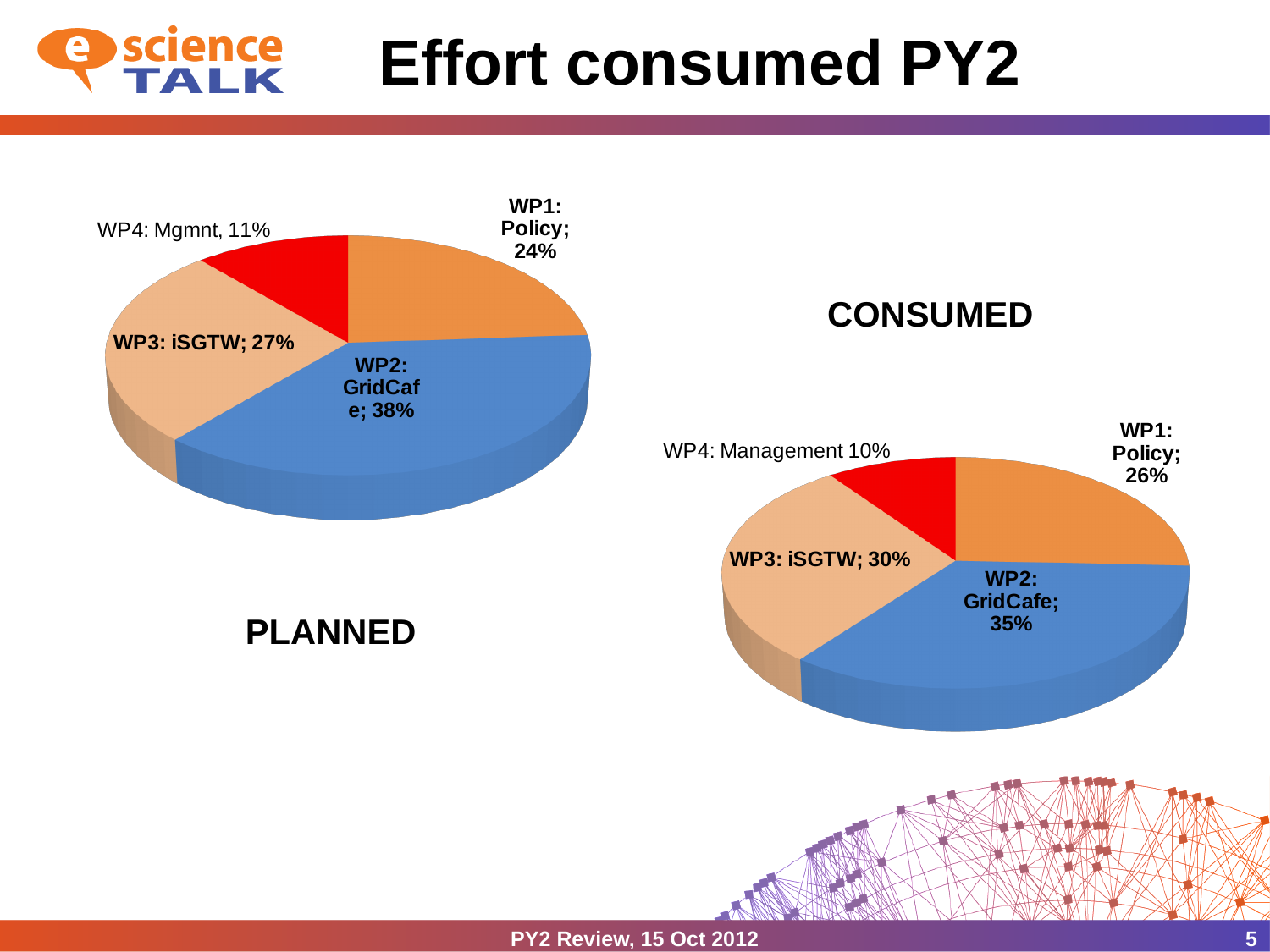
Which is larger: the WP1: Policy share in the PLANNED chart or the WP1: Policy share in the CONSUMED chart? CONSUMED In the PLANNED pie chart, what is the value for WP4: Mgmnt? 11% What type of chart is the CONSUMED chart? Pie chart In the CONSUMED pie chart, which work package has the smallest share? WP4: Management How many slices does the PLANNED pie chart have? 4 In the CONSUMED pie chart, what is the difference between the WP2: GridCafe share and the WP1: Policy share? 9% In the PLANNED pie chart, which work package has the largest share? WP2: GridCafe In the CONSUMED pie chart, what is the value for WP1: Policy? 26% In the CONSUMED pie chart, what share of effort is WP3: iSGTW? 30% In the PLANNED pie chart, what is the difference between the WP3: iSGTW share and the WP4: Mgmnt share? 16% What colour is the WP4 slice in both pie charts? Red In the PLANNED pie chart, what share of effort is WP2: GridCafe? 38%